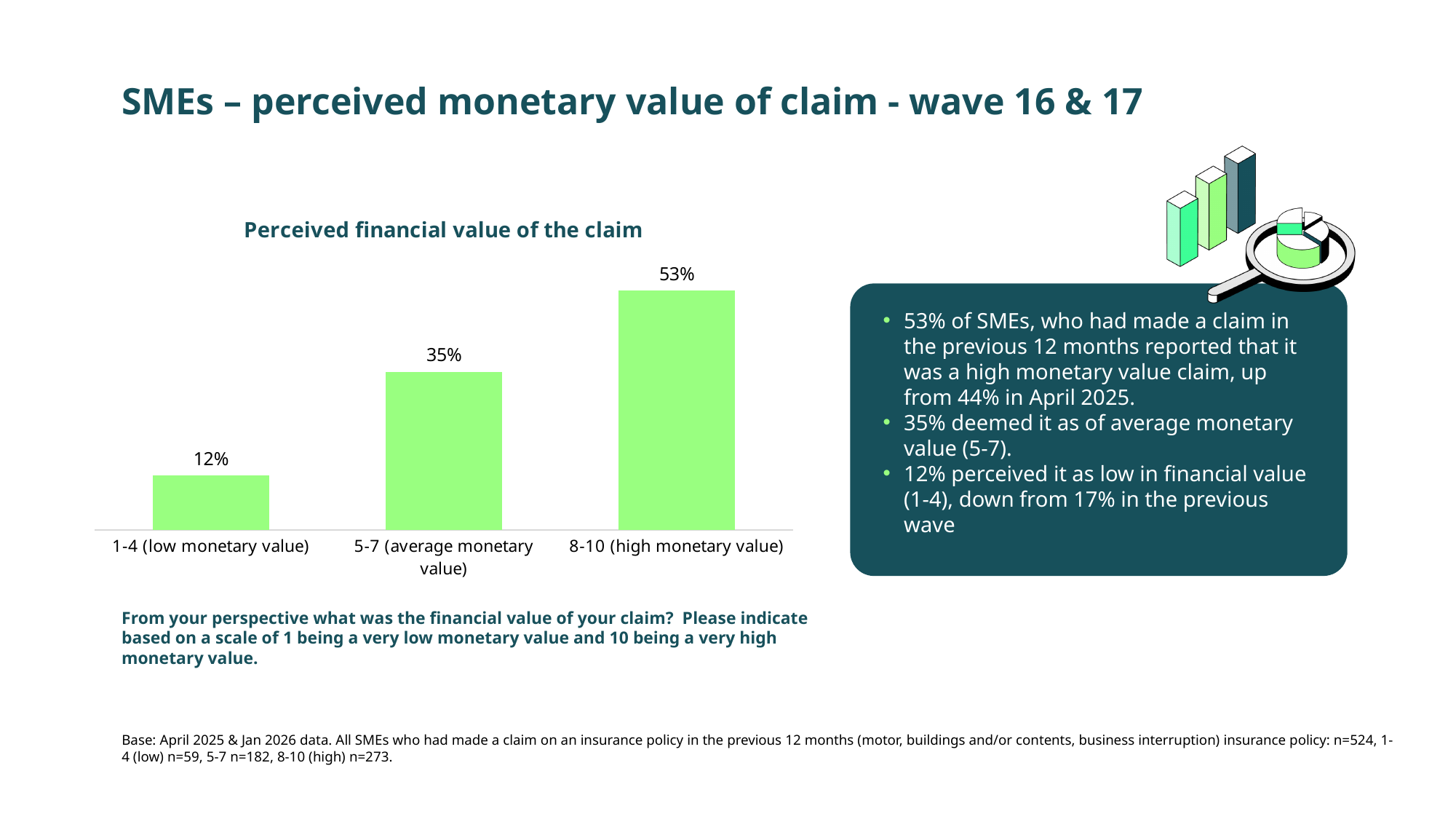
What is the title of the chart? Perceived financial value of the claim What is the value for 5-7 (average monetary value)? 35% What kind of chart is shown on the slide? Bar chart What is the value for 1-4 (low monetary value)? 12% What is the value for 8-10 (high monetary value)? 53% What is the difference between the values for 8-10 (high monetary value) and 5-7 (average monetary value)? 18% Which category has the highest value? 8-10 (high monetary value) Do the values rise or fall from left to right along the x axis? Rise What is the difference between the values for 5-7 (average monetary value) and 1-4 (low monetary value)? 23% How many categories are shown in the chart? 3 Which is larger, the value for 1-4 (low monetary value) or 5-7 (average monetary value)? 5-7 (average monetary value) Which category has the lowest value? 1-4 (low monetary value)